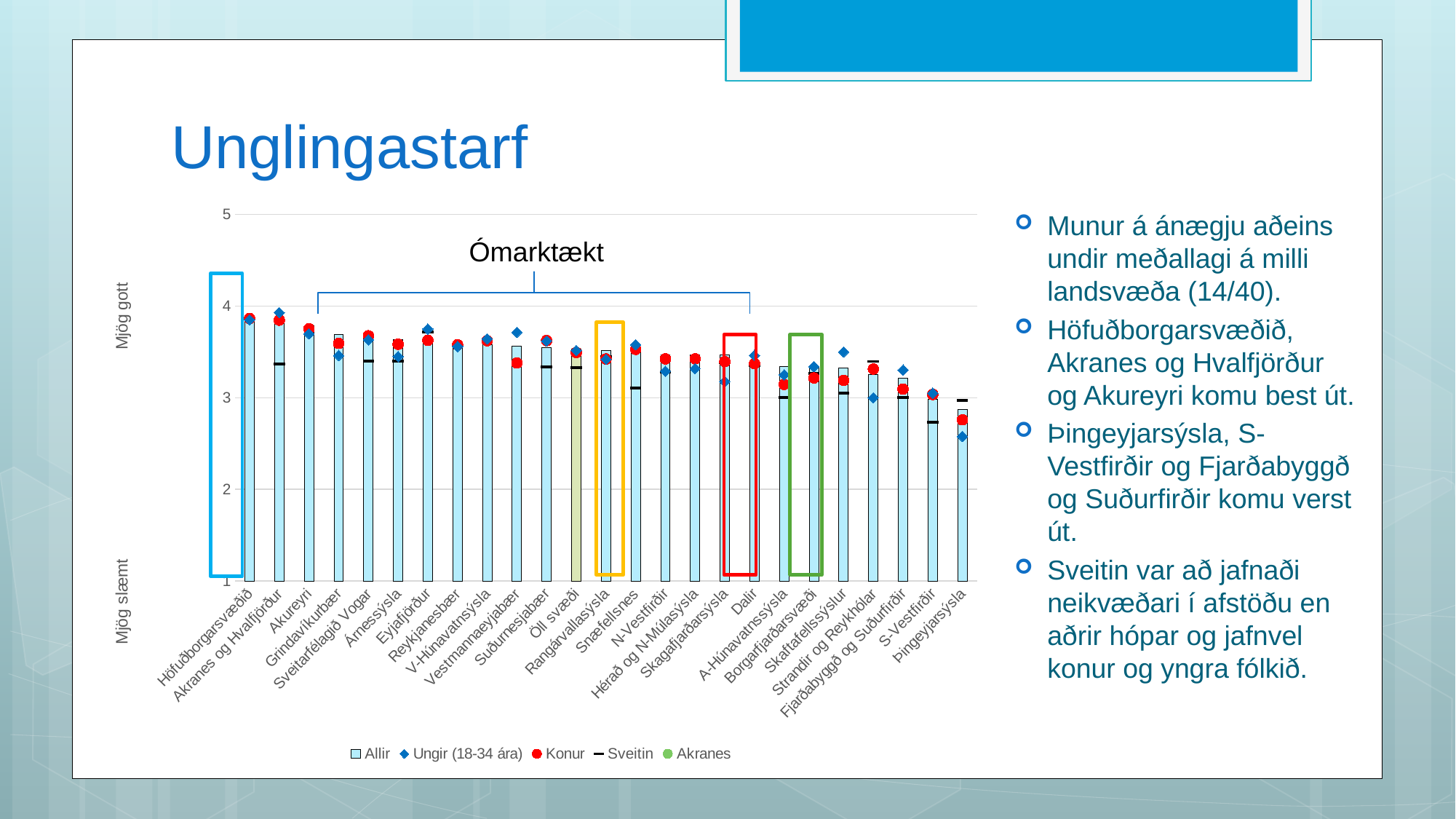
What is the title of the slide containing the chart? Unglingastarf How many series does the chart legend list? 5 What kind of chart is shown on the slide? Bar chart Which region has the highest 'Allir' bar in the chart? Höfuðborgarsvæðið How many categories (regions) are shown along the x axis of the chart? 25 Is the 'Allir' value for Höfuðborgarsvæðið greater or less than 4? less Is the 'Ungir (18-34 ára)' value for Þingeyjarsýsla greater or less than 3? less Is the 'Allir' value for Akureyri greater or less than 3? greater Do the 'Allir' bar values generally rise or fall from left to right along the x axis? Fall Which region has the lowest 'Allir' bar in the chart? Þingeyjarsýsla Which has the larger 'Allir' value, Höfuðborgarsvæðið or S-Vestfirðir? Höfuðborgarsvæðið